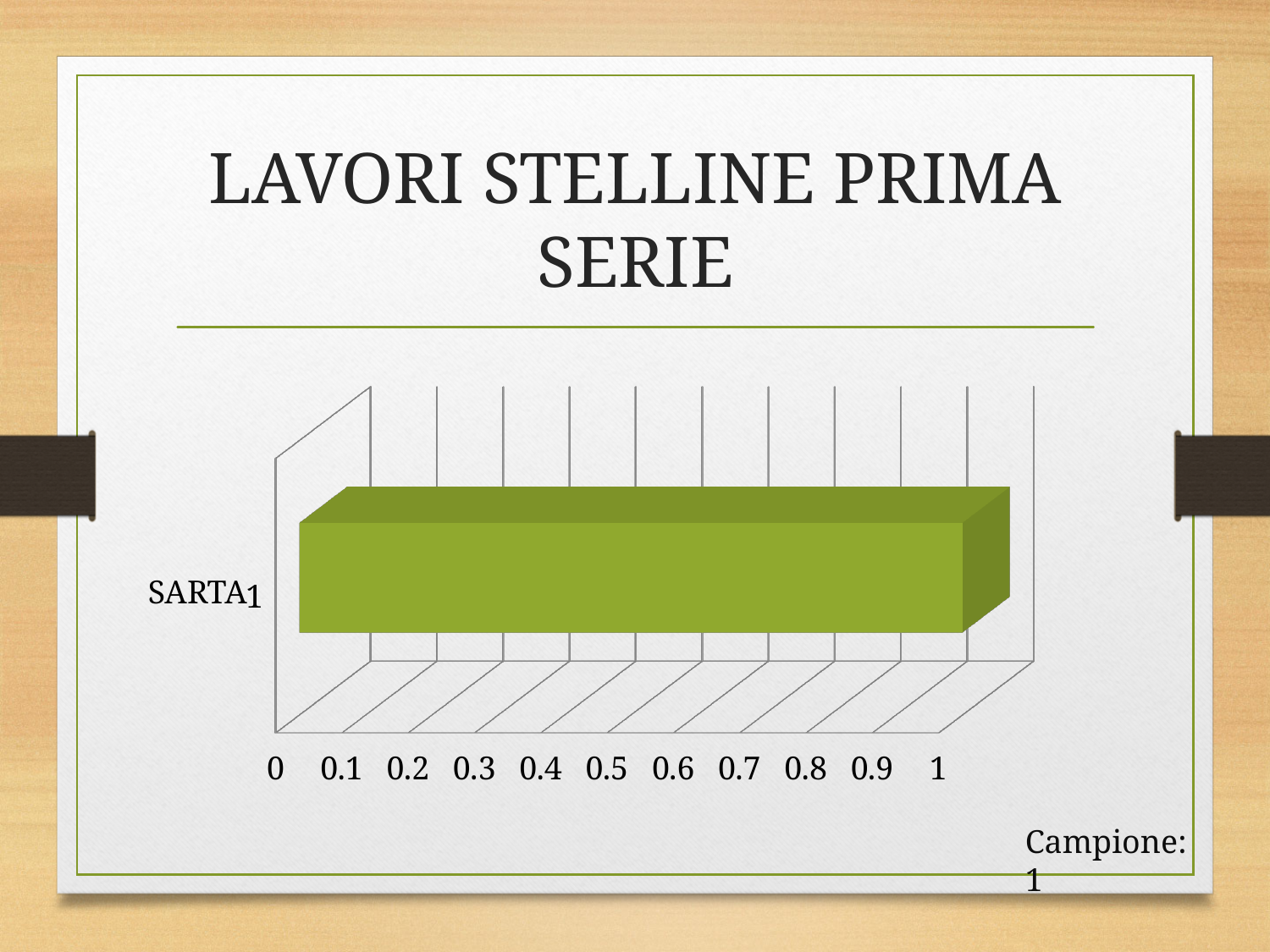
Is the value for SARTA greater or less than 0.5? greater What kind of chart is shown on the slide? bar chart Which category has the highest value in the chart? SARTA How many categories are plotted in the chart? 1 What colour is the bar in the chart? green What is the value for SARTA? 1 What is the highest value shown on the chart's value axis? 1 Is the value for SARTA greater or less than 0.9? greater What is the title of the slide containing the chart? LAVORI STELLINE PRIMA SERIE